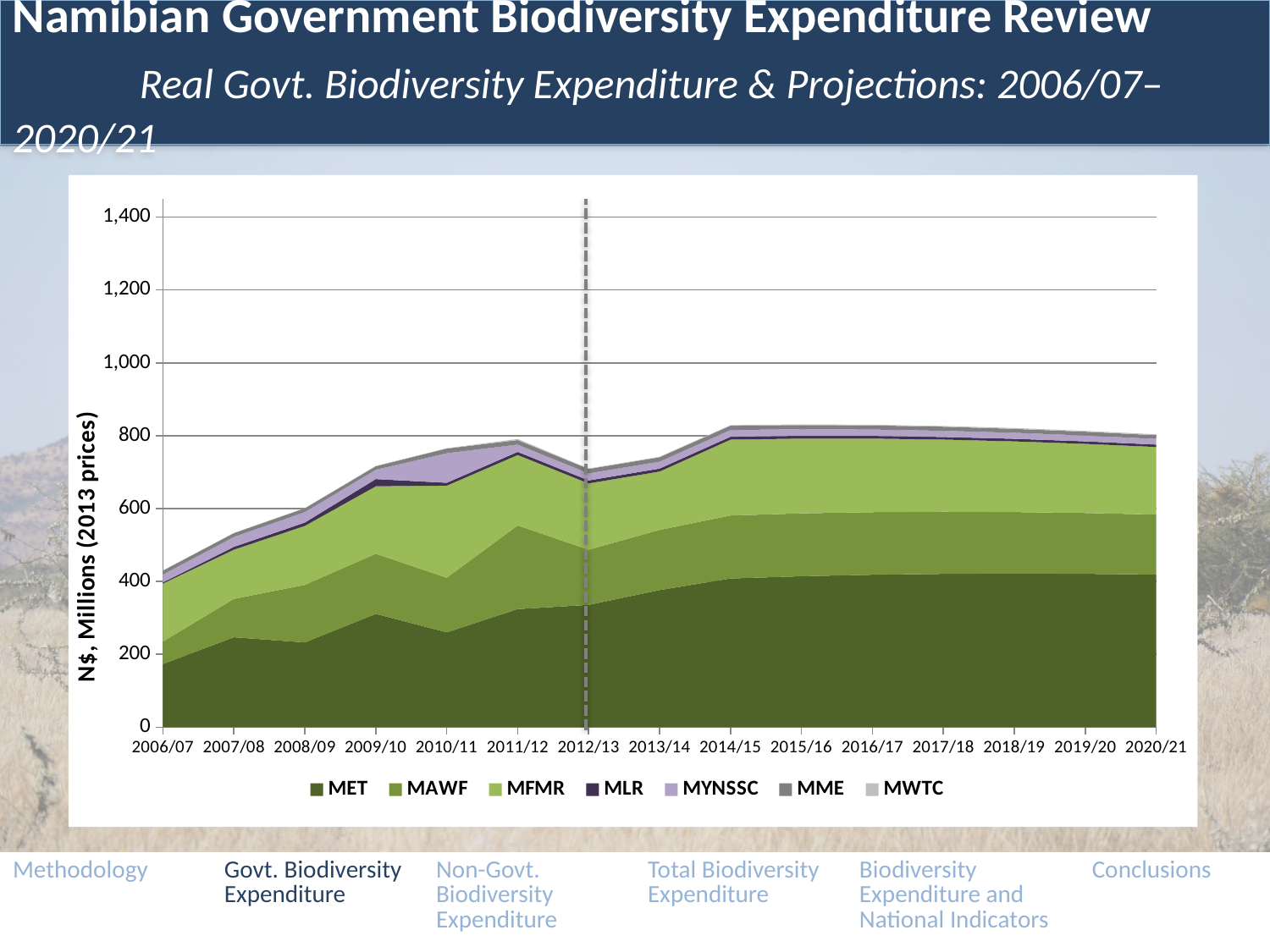
What kind of chart is shown on the slide? Stacked area chart What is the label on the y axis? N$, Millions (2013 prices) Is the total stacked value in 2006/07 greater or less than 600? less Is the value for MET in 2006/07 greater or less than 200? less Is the MET value larger in 2006/07 or in 2020/21? 2020/21 Is the value for MET in 2020/21 greater or less than 400? greater Which series is listed first in the legend? MET Which year has the lowest total stacked expenditure? 2006/07 How many series does the legend list? 7 How many fiscal years are shown along the x axis? 15 Does the MET series generally rise or fall from 2006/07 to 2020/21? rise